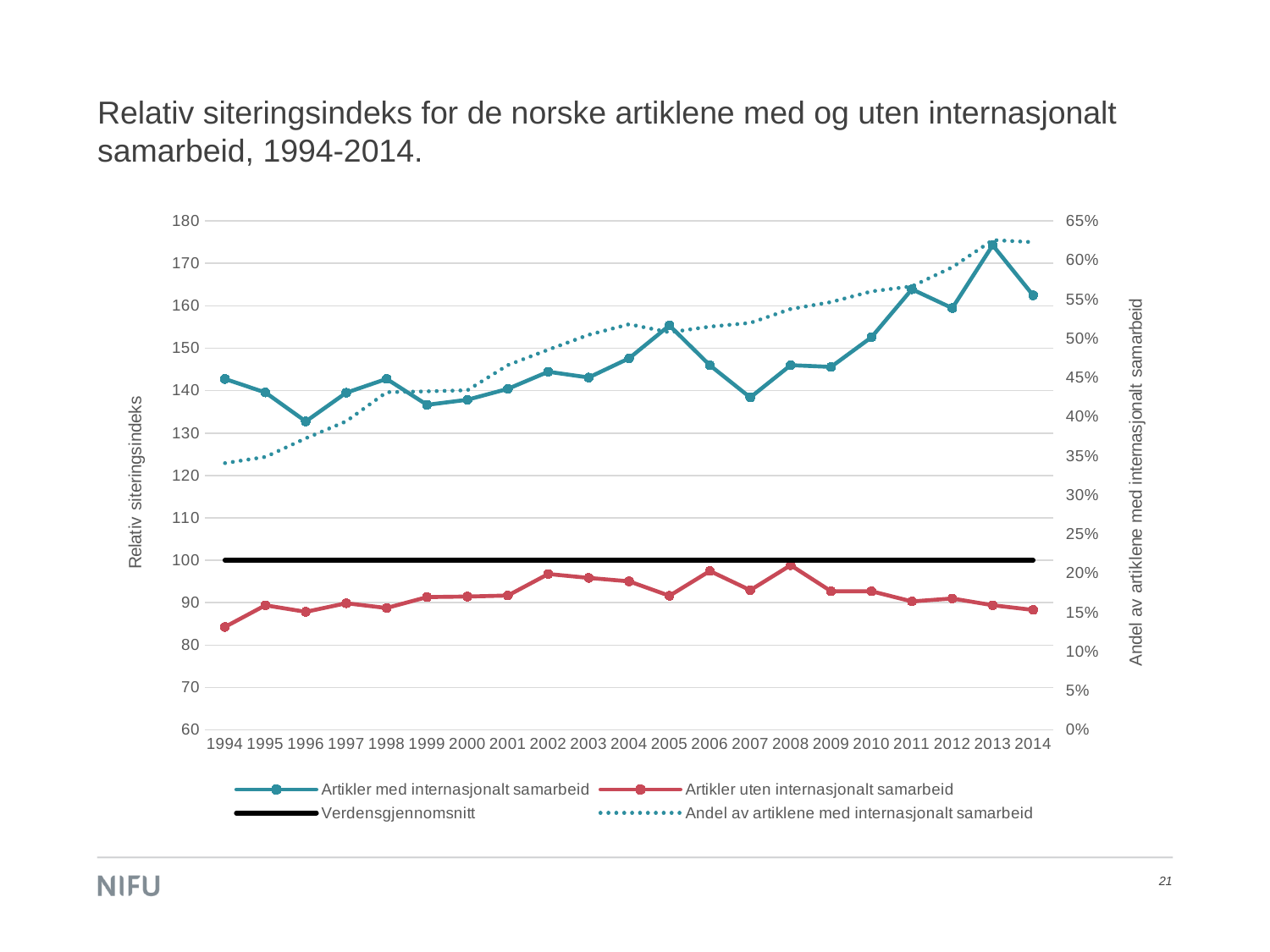
In which year is the value for Artikler med internasjonalt samarbeid lowest? 1996 What kind of chart is shown on the slide? line chart Is the value for Artikler med internasjonalt samarbeid in 2013 greater or less than 170? greater How many series does the legend list? 4 What is the label of the right-hand vertical axis? Andel av artiklene med internasjonalt samarbeid Which is larger for Artikler med internasjonalt samarbeid: the value in 2013 or the value in 2014? 2013 What value does the Verdensgjennomsnitt line sit at on the left axis? 100 In which year is the value for Artikler uten internasjonalt samarbeid lowest? 1994 Does the Andel av artiklene med internasjonalt samarbeid series generally rise or fall from 1994 to 2014? rise In which year is the value for Artikler med internasjonalt samarbeid highest? 2013 Is the value for Artikler uten internasjonalt samarbeid in 1994 greater or less than 90? less How many years are plotted along the x axis? 21